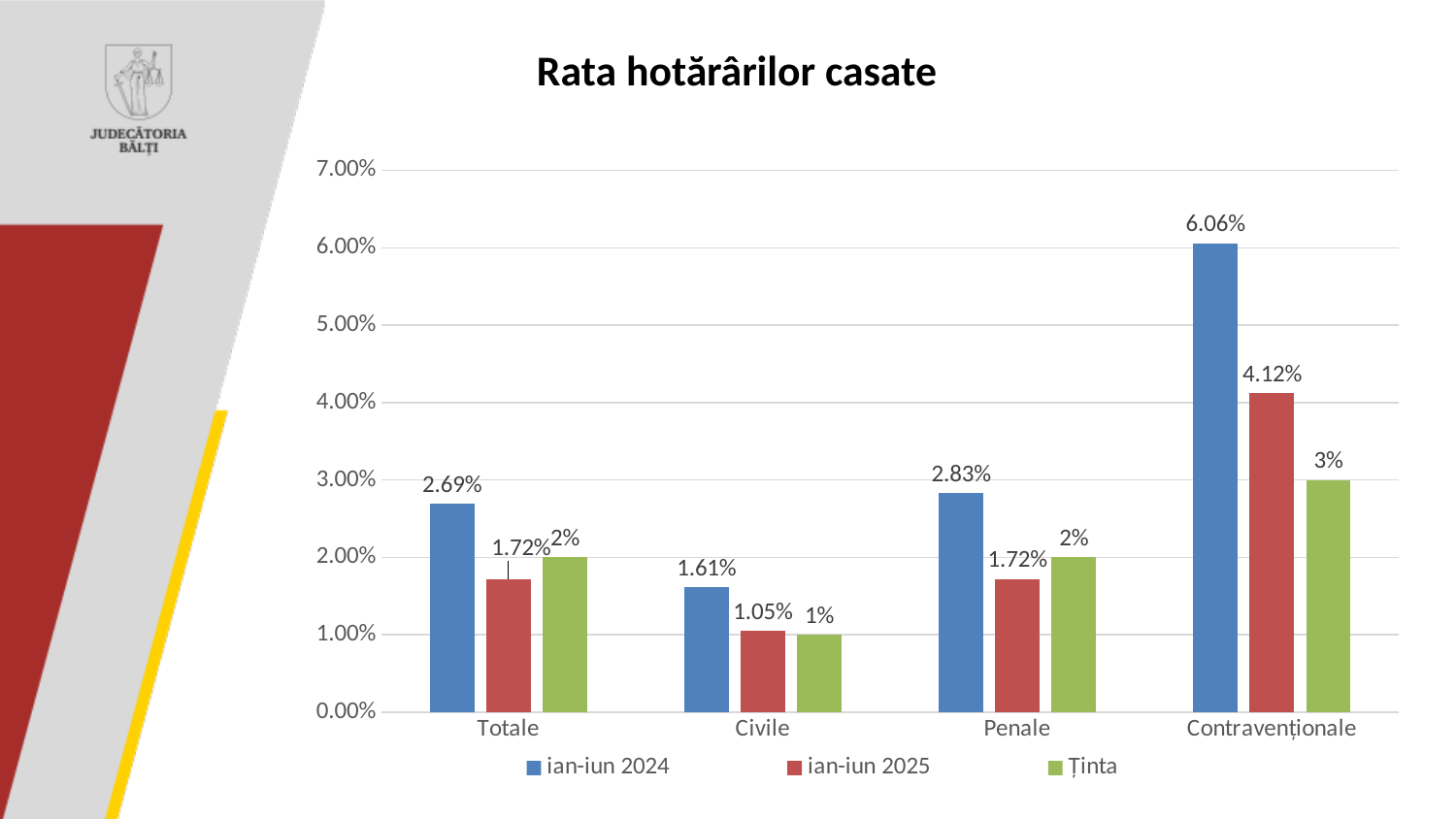
What is the Ținta value for Penale? 2% How many series does the legend list? 3 Which is larger for Totale: the ian-iun 2024 value or the ian-iun 2025 value? ian-iun 2024 What is the value for Civile in the ian-iun 2025 series? 1.05% What is the difference between the ian-iun 2024 and ian-iun 2025 values for Contravenționale? 1.94% What kind of chart is shown on the slide? Bar chart How many categories are shown on the x axis? 4 Is the ian-iun 2025 value for Contravenționale greater or less than 4.00%? greater Which category has the lowest value in the ian-iun 2025 series? Civile What is the title of the chart? Rata hotărârilor casate What is the value for Contravenționale in the ian-iun 2024 series? 6.06% Which category has the highest value in the ian-iun 2024 series? Contravenționale